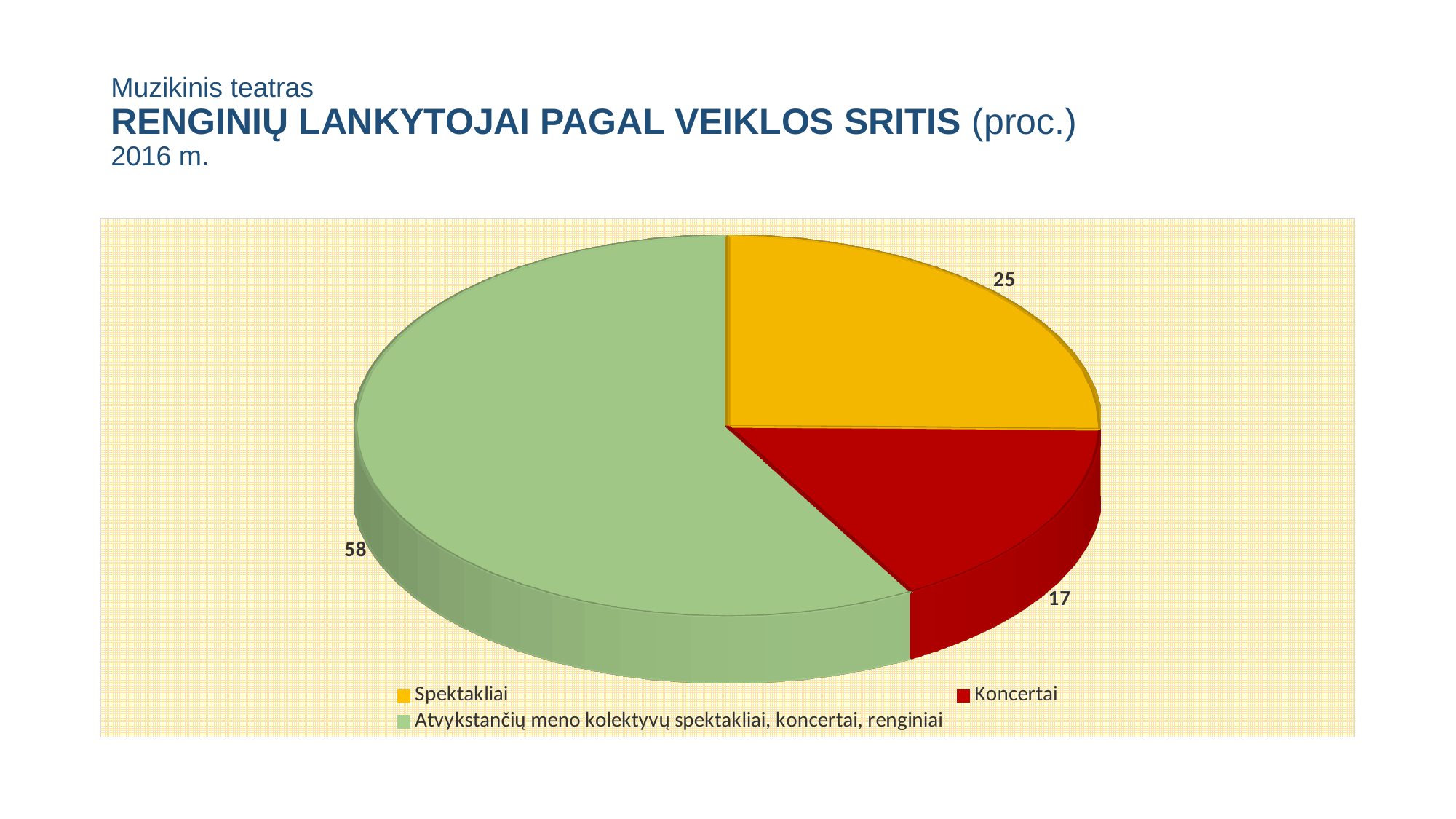
How many entries does the legend list? 3 What is the value for Koncertai? 17 What colour is the Koncertai slice? red What is the value for Spektakliai? 25 What is the difference between the values for Atvykstančių meno kolektyvų spektakliai, koncertai, renginiai and Spektakliai? 33 Which category has the smallest slice? Koncertai Which is larger, the value for Spektakliai or the value for Koncertai? Spektakliai What kind of chart is shown on the slide? pie chart How many slices does the pie chart have? 3 What is the difference between the values for Spektakliai and Koncertai? 8 Which category has the largest slice? Atvykstančių meno kolektyvų spektakliai, koncertai, renginiai What is the value for Atvykstančių meno kolektyvų spektakliai, koncertai, renginiai? 58